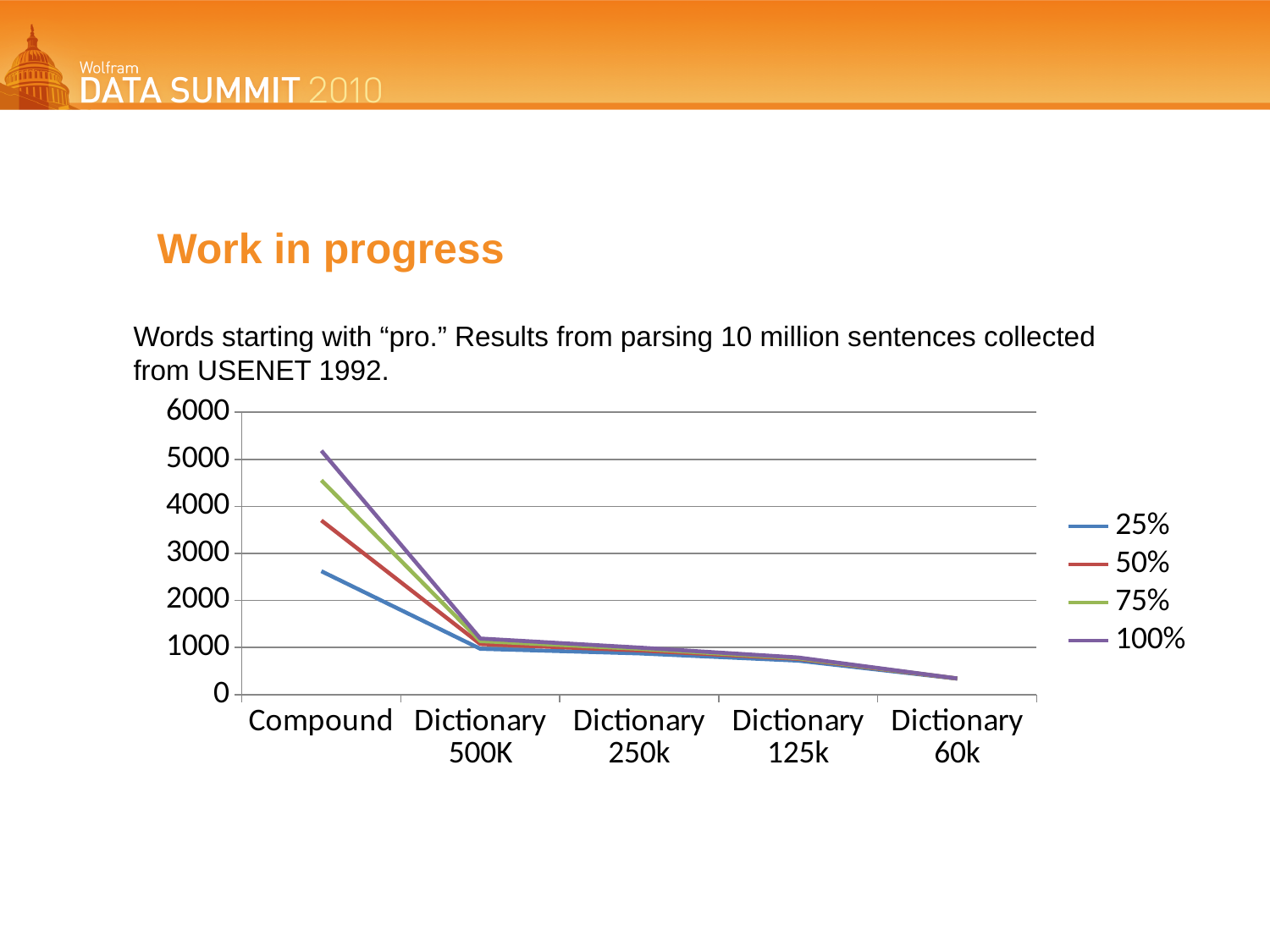
How many categories are shown along the x axis? 5 What are the entries listed in the chart legend? 25%, 50%, 75%, 100% How many series does the legend list? 4 For the 25% series, which category has the lowest value? Dictionary 60k Is the value for the 100% series at Compound greater or less than 4000? greater What kind of chart is shown on the slide? line chart Is the value for the 100% series at Dictionary 60k greater or less than 1000? less For the 100% series, which category has the highest value? Compound Do the values of the 100% series rise or fall moving from Compound to Dictionary 60k? fall At the Compound category, which series is larger, 100% or 25%? 100% At the Compound category, which series is larger, 50% or 75%? 75% Is the value for the 25% series at Compound greater or less than 3000? less